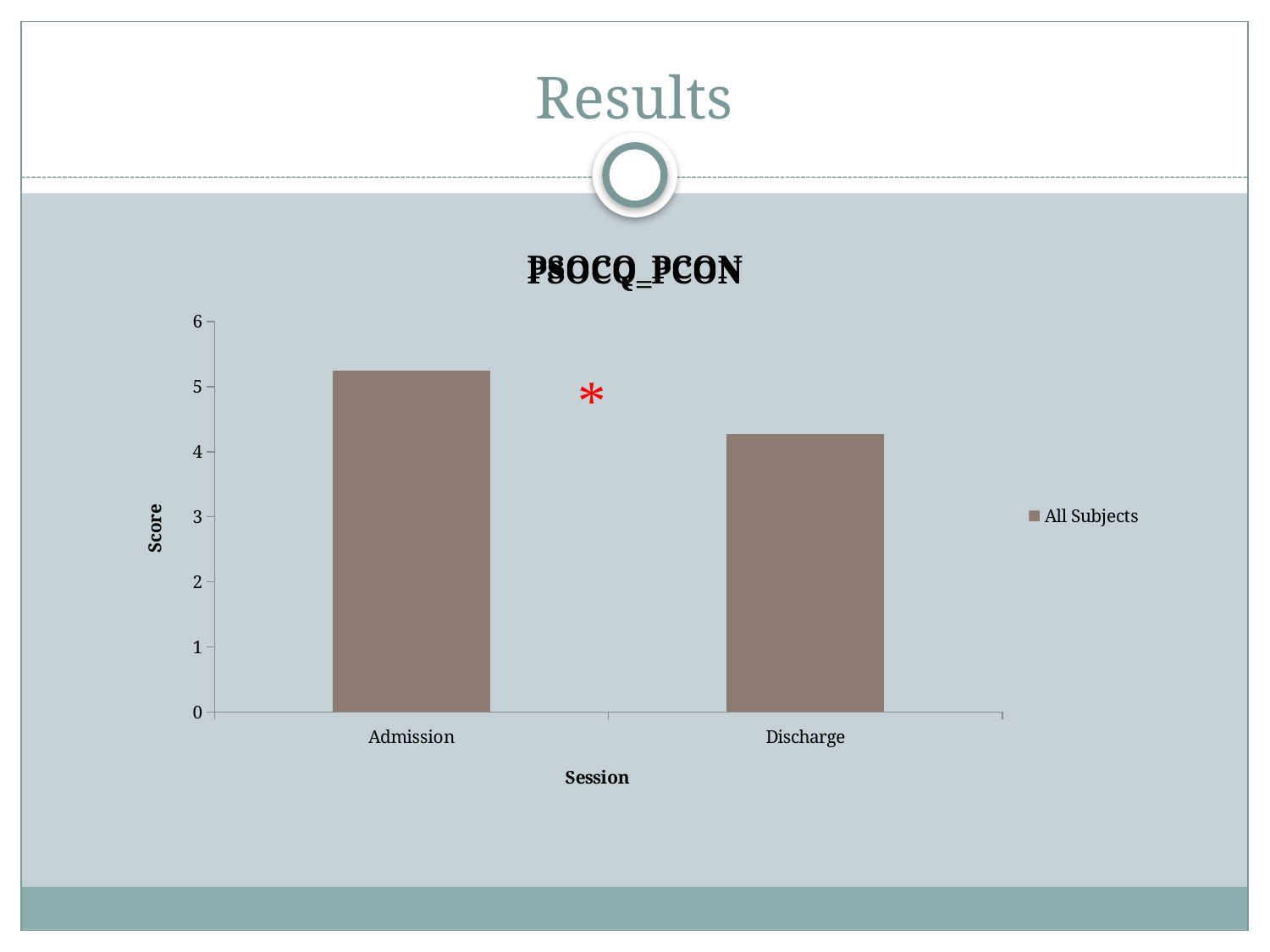
Does the score rise or fall from Admission to Discharge? fall How many categories are shown on the x axis of the chart? 2 What kind of chart is shown on the slide? bar chart What is the label of the y axis of the chart? Score Is the value for Discharge greater or less than 4? greater Which category has the highest bar in the chart? Admission Is the value for Discharge greater or less than 5? less Which session has the higher score, Admission or Discharge? Admission Which category has the lowest bar in the chart? Discharge What series name appears in the chart's legend? All Subjects How many series does the chart's legend list? 1 Is the value for Admission greater or less than 5? greater